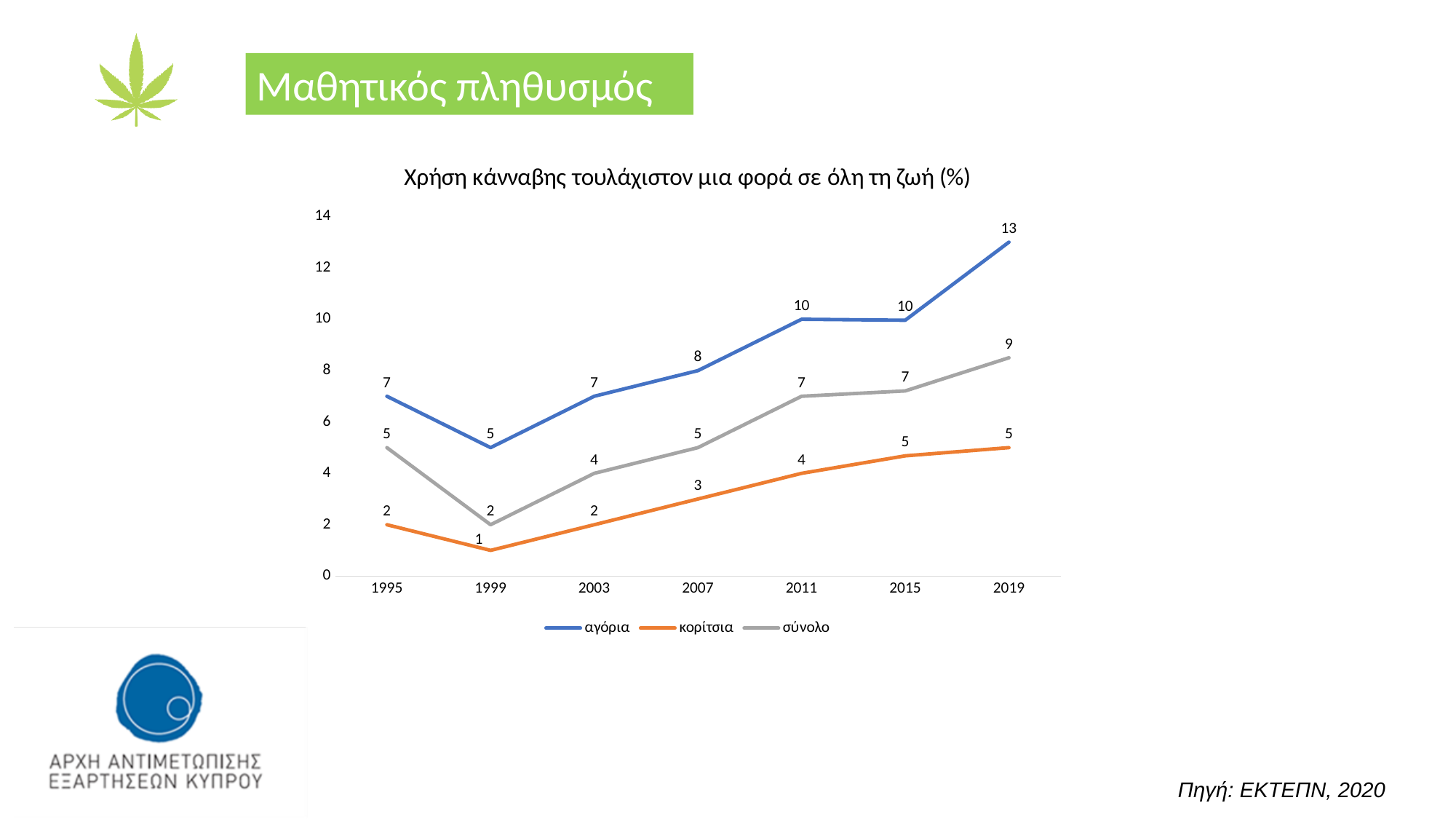
Which is larger in 2007: the value for αγόρια or the value for σύνολο? αγόρια What is the value for σύνολο in 2011? 7 How many series does the legend list? 3 What is the value for αγόρια in 2019? 13 In which year is the value for σύνολο highest? 2019 How many years are shown on the x axis? 7 What is the value for κορίτσια in 1999? 1 In which year is the value for αγόρια lowest? 1999 What kind of chart is shown on the slide? line chart What is the difference between the αγόρια and κορίτσια values in 2019? 8 What is the title of the chart? Χρήση κάνναβης τουλάχιστον μια φορά σε όλη τη ζωή (%) Does the value for κορίτσια rise or fall from 1999 to 2019? rise